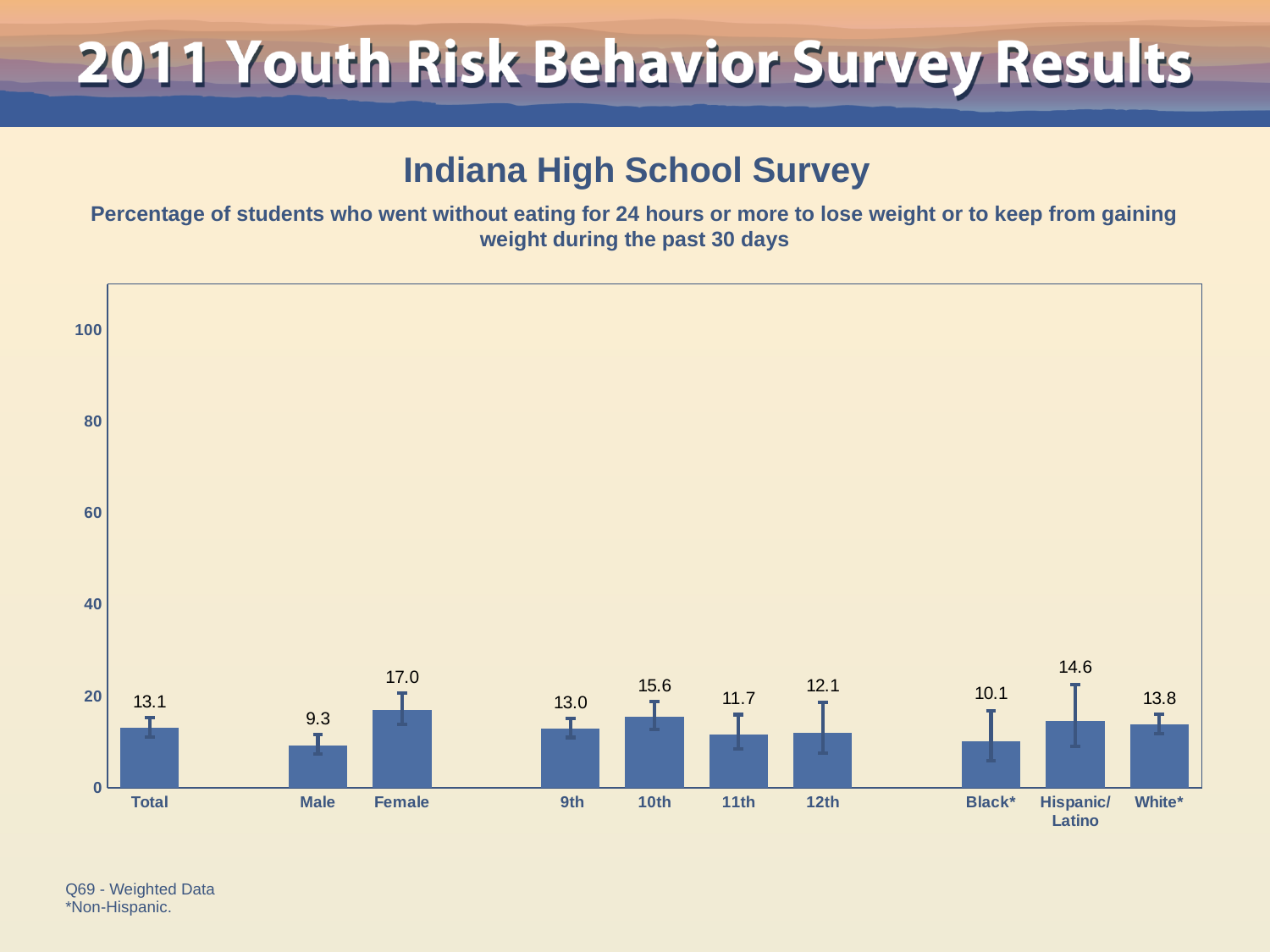
Do the values rise or fall from 10th to 11th? fall What is the difference between the values for Female and Male? 7.7 Is the value for Hispanic/Latino greater or less than 20? less What is the title of the chart? Indiana High School Survey What is the value for Female? 17.0 What kind of chart is this? bar chart Which is larger, the value for 10th or the value for 12th? 10th Which category has the highest value? Female Which category has the lowest value? Male What is the value for Total? 13.1 How many categories are shown on the x axis? 10 What is the value for Black*? 10.1